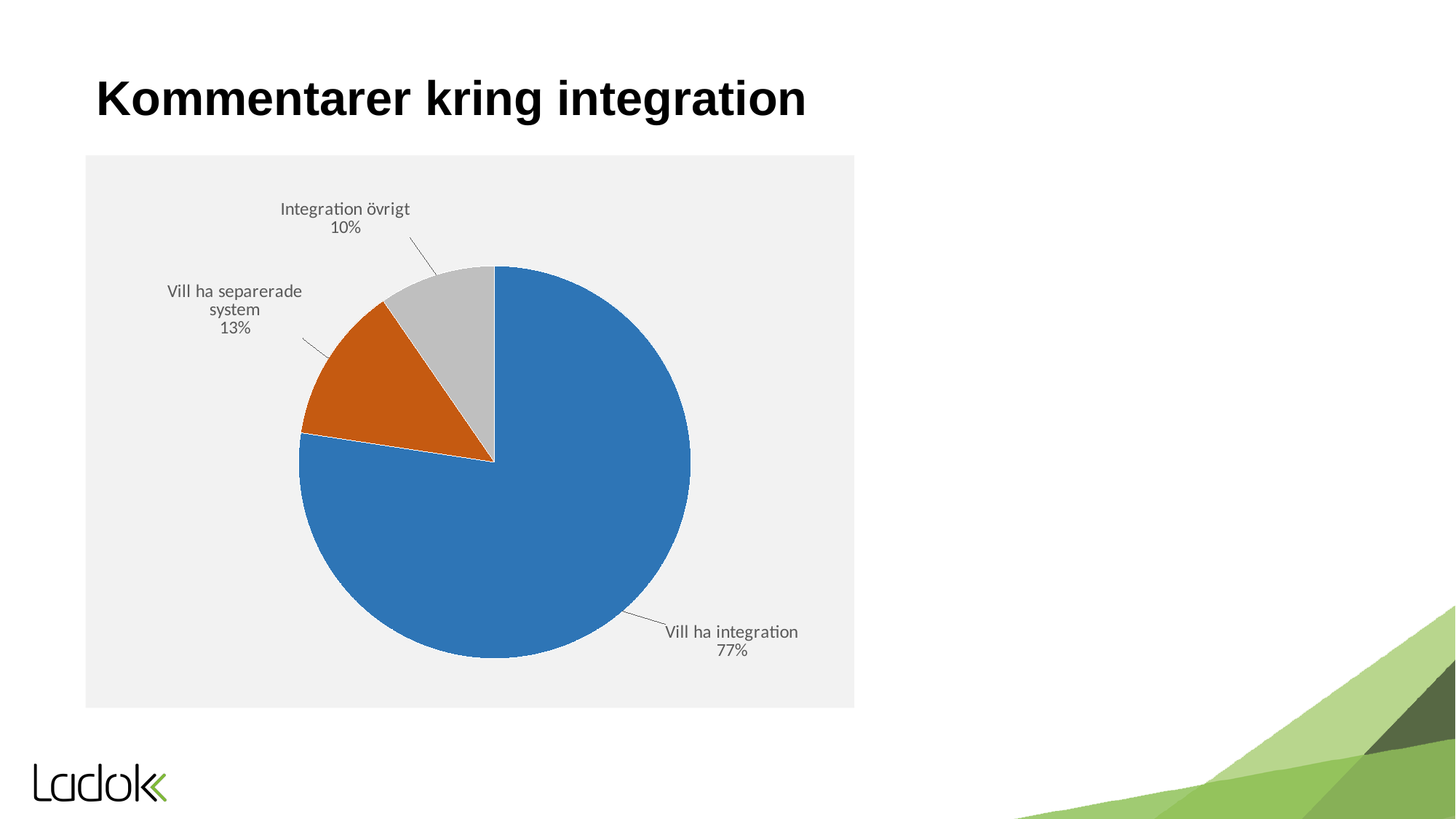
How many slices does the pie chart have? 3 What is the difference in percentage points between "Vill ha separerade system" and "Integration övrigt"? 3 What is the title of the slide containing the chart? Kommentarer kring integration Which category has the smallest slice of the pie? Integration övrigt What kind of chart is shown on the slide? Pie chart What is the difference in percentage points between "Vill ha integration" and "Vill ha separerade system"? 64 What share of the pie does "Integration övrigt" represent? 10% Which category has the largest slice of the pie? Vill ha integration What share of the pie does "Vill ha integration" represent? 77% What colour is the slice for "Vill ha separerade system"? Orange What share of the pie does "Vill ha separerade system" represent? 13% Which is larger, the slice for "Vill ha separerade system" or the slice for "Integration övrigt"? Vill ha separerade system